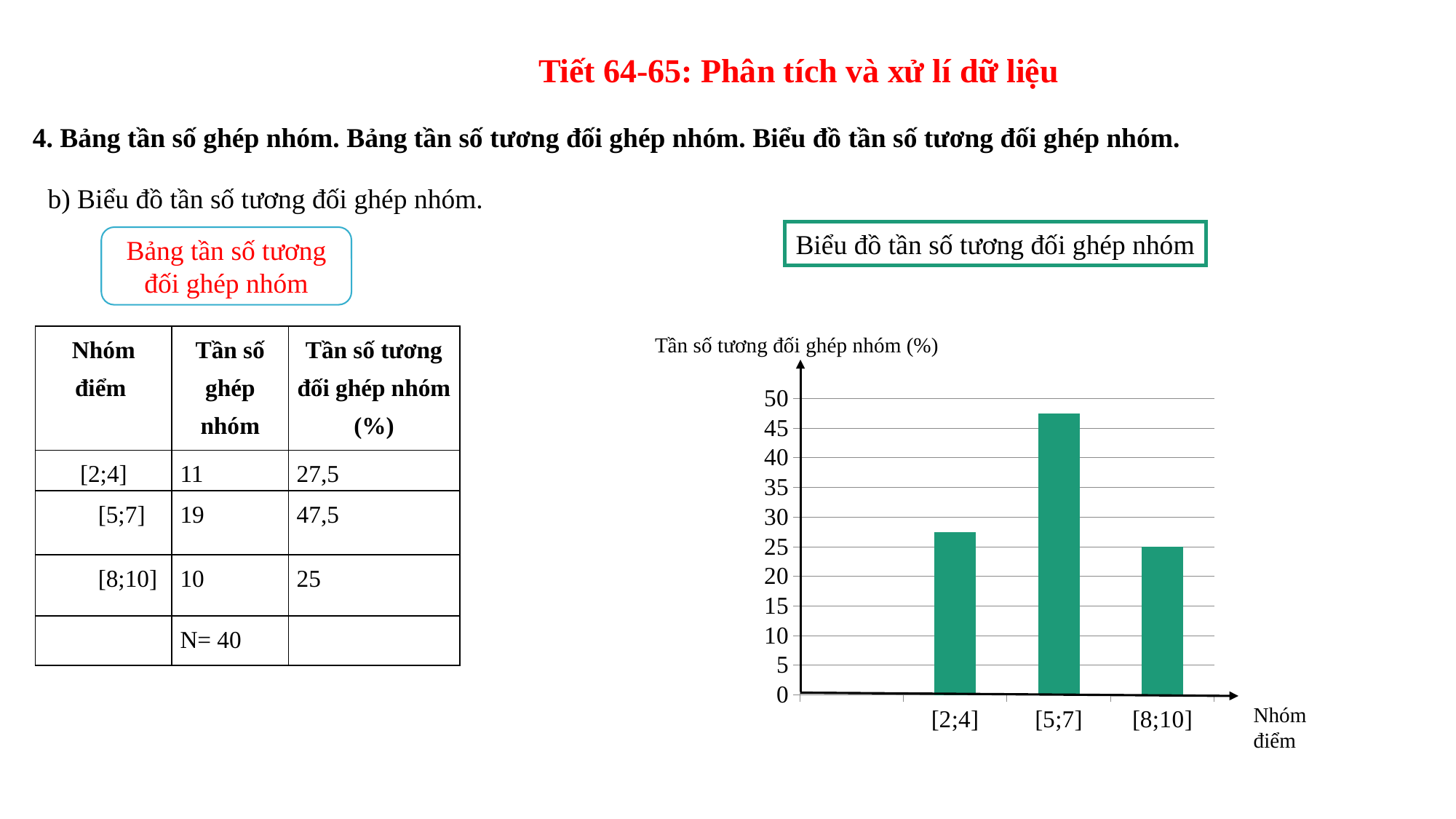
Which bar is taller in the chart, [2;4] or [8;10]? [2;4] What is the label on the vertical axis of the chart? Tần số tương đối ghép nhóm (%) Which score group has the lowest bar in the chart? [8;10] What is the value (%) for the group [8;10] in the chart? 25 Is the value for the group [5;7] greater or less than 45? greater Is the value for the group [5;7] greater or less than 50? less Is the value for the group [2;4] greater or less than 25? greater Do the bar values rise or fall from [5;7] to [8;10] along the x axis? fall Which score group has the highest bar in the chart? [5;7] What kind of chart is shown on the slide? bar chart How many score groups (categories) are plotted on the x axis of the chart? 3